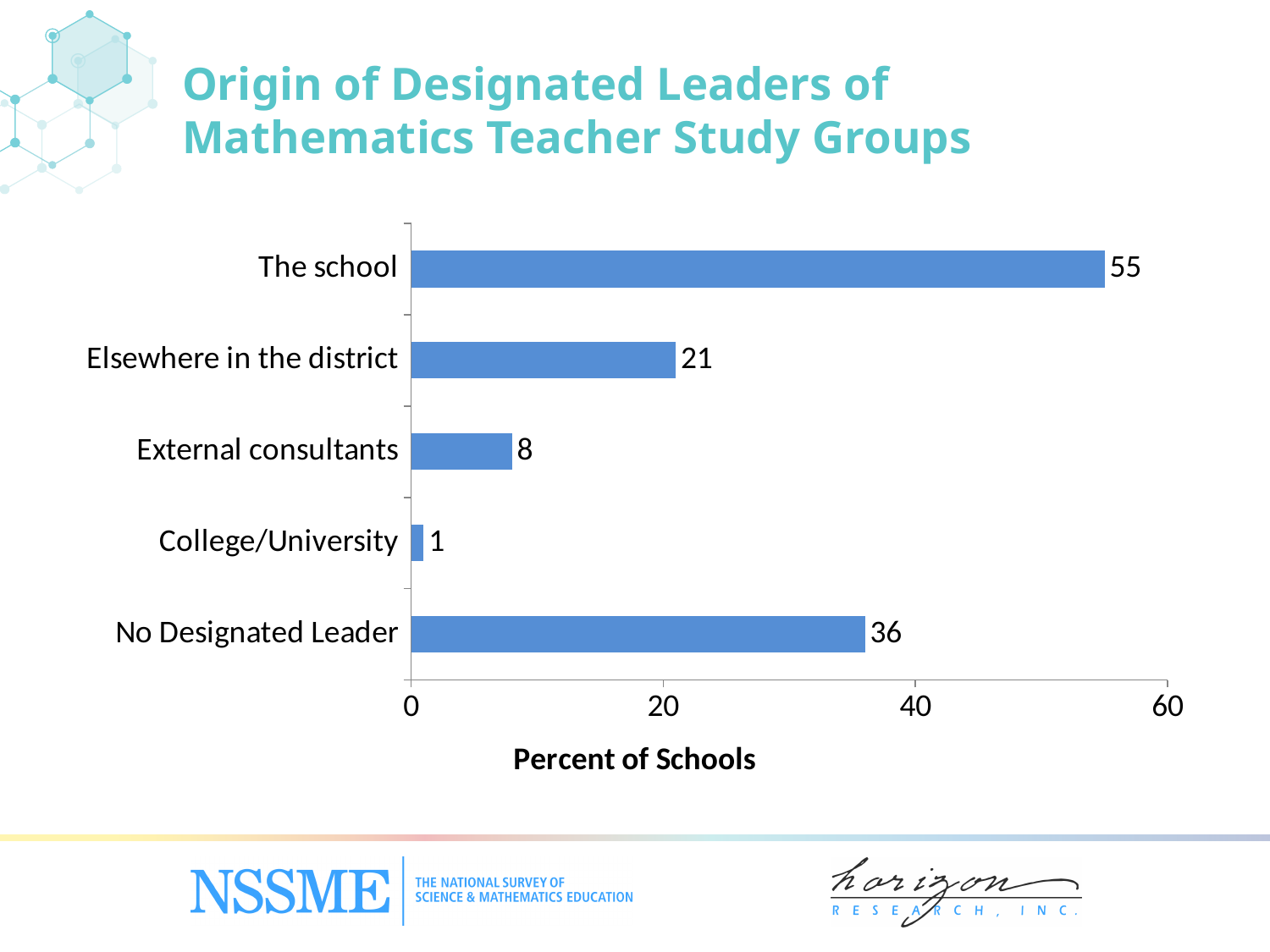
Is the value for The school greater or less than 40? greater What is the value for External consultants? 8 What is the value for Elsewhere in the district? 21 How many categories are shown in the chart? 5 What is the value for The school? 55 What kind of chart is shown on the slide? bar chart What is the value for No Designated Leader? 36 What is the label of the horizontal axis? Percent of Schools What is the difference between the values for The school and No Designated Leader? 19 Which category has the highest value? The school Which category has the lowest value? College/University Which is larger, the value for Elsewhere in the district or the value for No Designated Leader? No Designated Leader